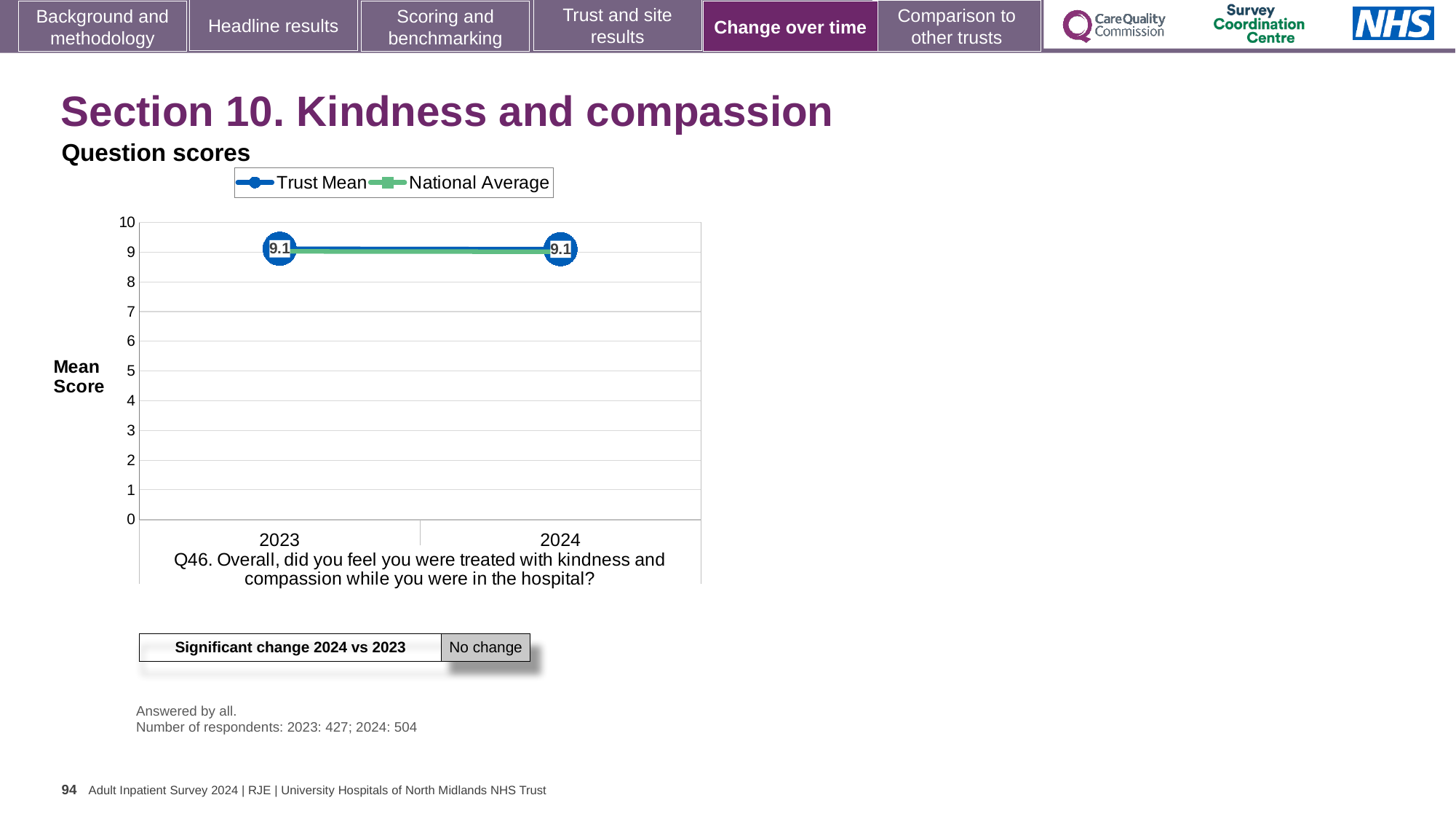
What is the Trust Mean score for 2024? 9.1 What is the difference between the Trust Mean scores for 2024 and 2023? 0.0 What kind of chart is shown on the slide? line chart Does the Trust Mean rise, fall or stay the same from 2023 to 2024? stays the same What is the Trust Mean score for 2023? 9.1 What is the label on the y axis of the chart? Mean Score How many series does the chart legend list? 2 Is the Trust Mean value for 2023 greater or less than 8? greater How many years are plotted on the x axis of the chart? 2 Is the National Average value for 2024 greater or less than 8? greater Which two series are listed in the chart legend? Trust Mean and National Average